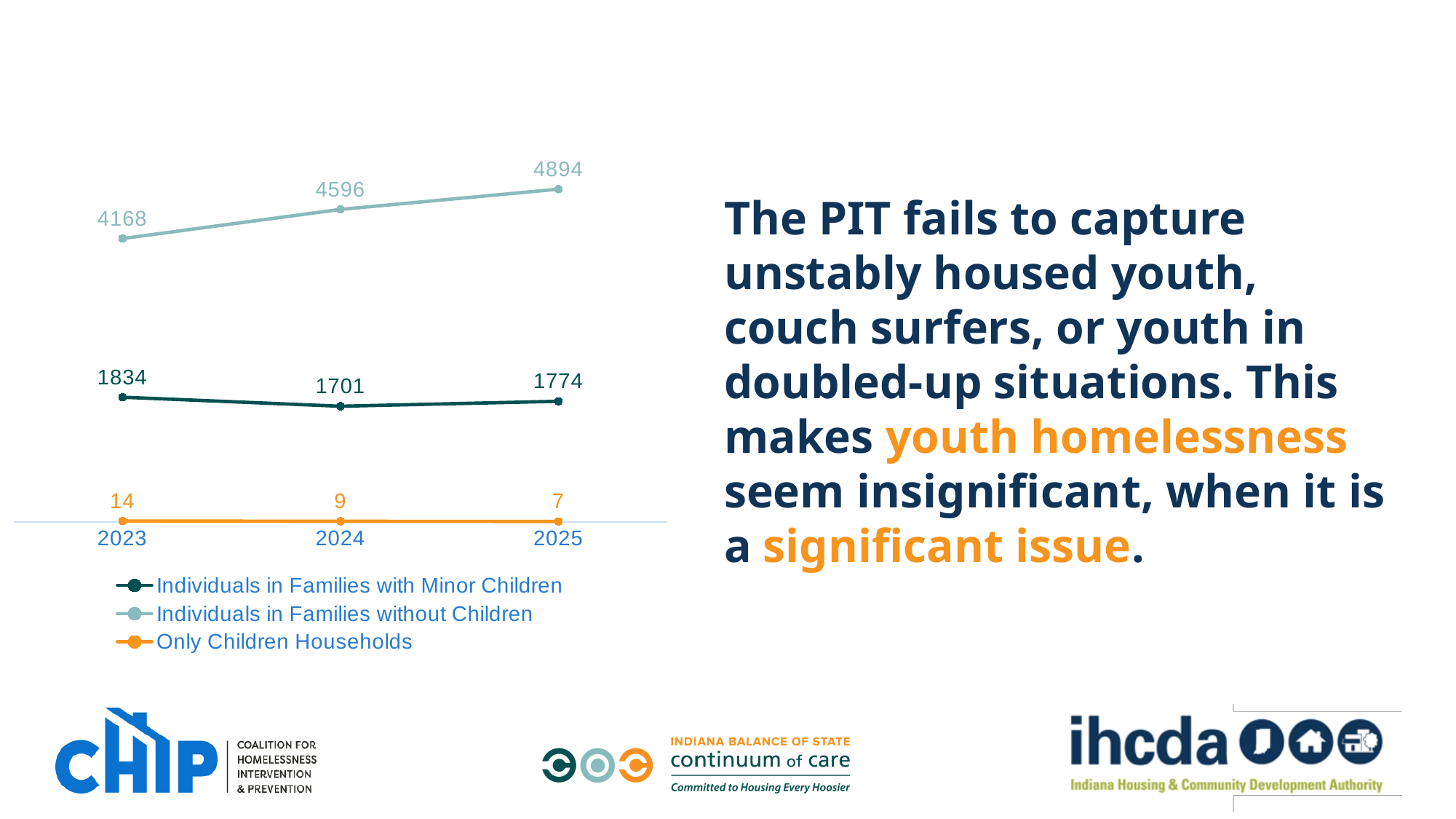
What is the value for Only Children Households in 2023? 14 What is the value for Individuals in Families without Children in 2025? 4894 What is the difference between the 2023 and 2025 values for Only Children Households? 7 How many years are shown on the x axis? 3 What kind of chart is shown on the slide? Line chart In which year is the value for Individuals in Families with Minor Children lowest? 2024 What is the value for Individuals in Families with Minor Children in 2024? 1701 Do the values for Only Children Households rise or fall from 2023 to 2025? Fall Which is larger: Individuals in Families with Minor Children in 2023 or in 2025? 2023 How many series does the legend list? 3 What is the difference between the 2025 and 2023 values for Individuals in Families without Children? 726 In which year is the value for Individuals in Families without Children highest? 2025